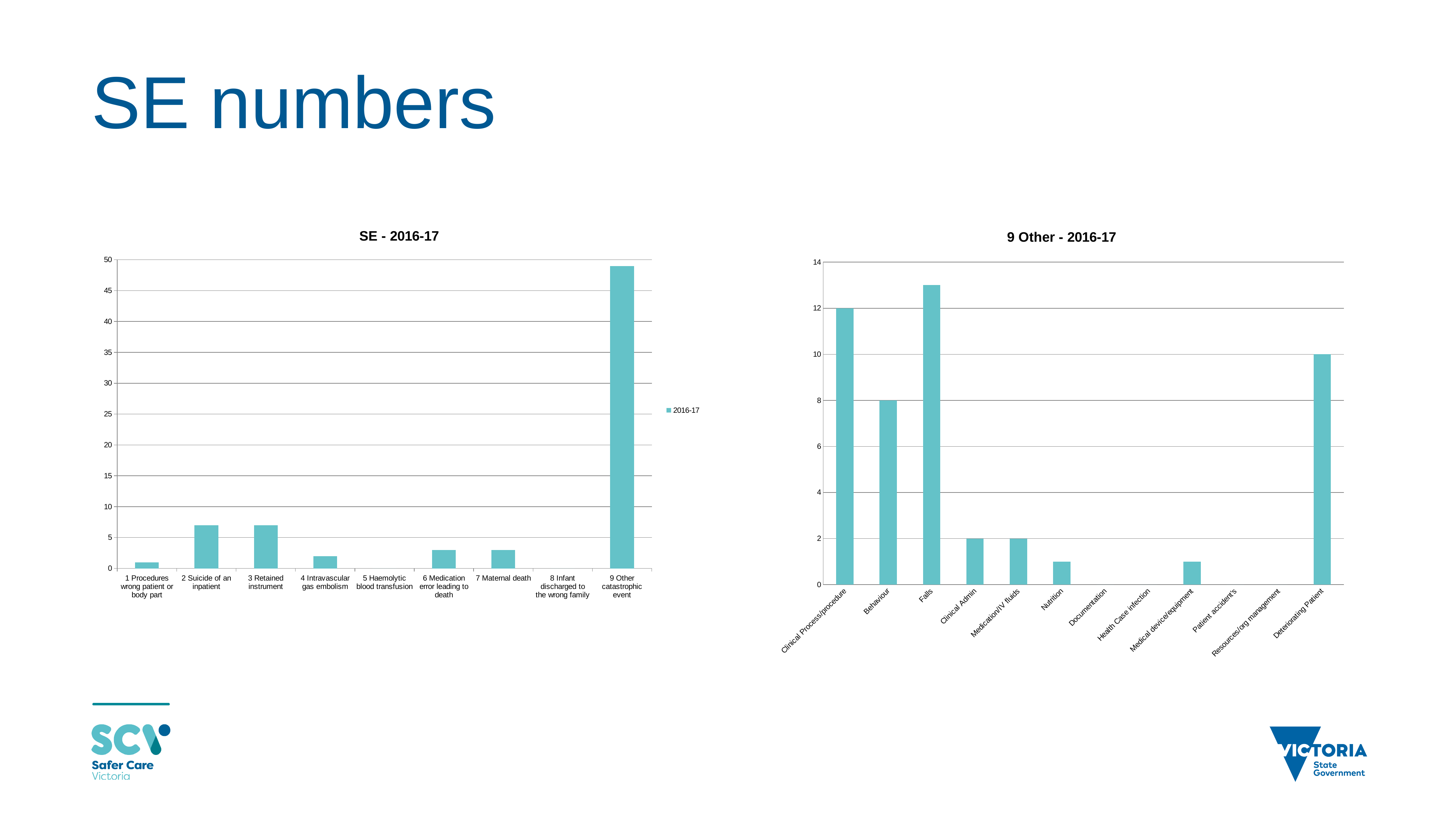
In the '9 Other - 2016-17' chart, which is larger, Behaviour or Deteriorating Patient? Deteriorating Patient In the 'SE - 2016-17' chart, is the value for '2 Suicide of an inpatient' greater or less than 5? greater In the '9 Other - 2016-17' chart, what is the difference between Clinical Process/procedure and Behaviour? 4 In the '9 Other - 2016-17' chart, what is the value for Clinical Process/procedure? 12 What kind of chart is the 'SE - 2016-17' chart? bar chart In the 'SE - 2016-17' chart, how many categories are shown on the x axis? 9 In the '9 Other - 2016-17' chart, what is the value for Deteriorating Patient? 10 In the 'SE - 2016-17' chart, which category has the highest value? 9 Other catastrophic event In the 'SE - 2016-17' chart, is the value for '9 Other catastrophic event' greater or less than 45? greater In the '9 Other - 2016-17' chart, what is the value for Behaviour? 8 In the '9 Other - 2016-17' chart, which category has the highest value? Falls In the 'SE - 2016-17' chart, how many series does the legend list? 1